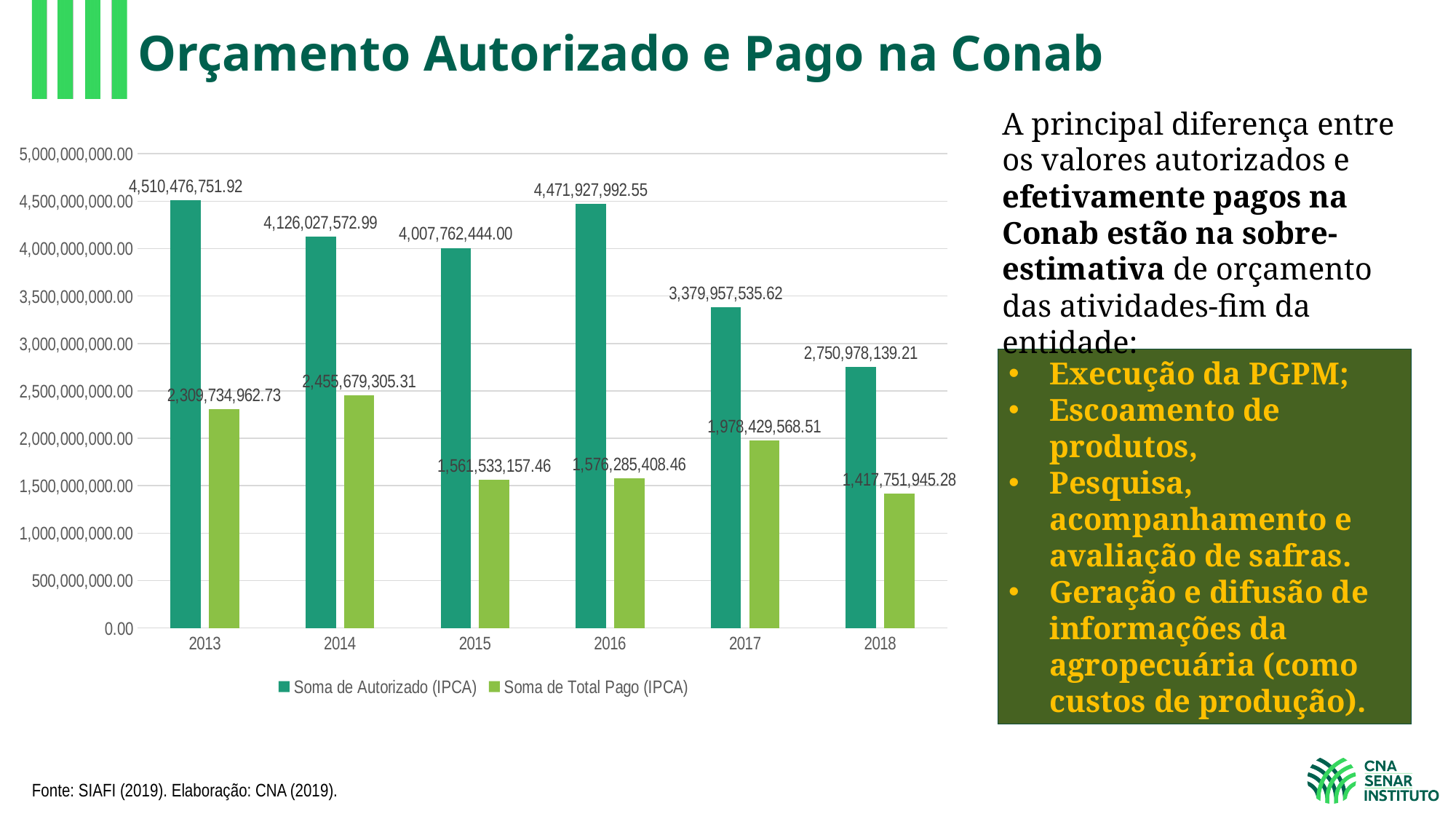
Is the value of Soma de Autorizado (IPCA) for 2017 greater or less than 3,000,000,000.00? greater In which year is Soma de Total Pago (IPCA) lowest? 2018 How many series does the chart legend list? 2 How many years are shown on the x axis of the chart? 6 What is the value of Soma de Total Pago (IPCA) for 2017? 1,978,429,568.51 Does Soma de Autorizado (IPCA) rise or fall from 2016 to 2018? fall What is the value of Soma de Autorizado (IPCA) for 2016? 4,471,927,992.55 In which year is Soma de Autorizado (IPCA) highest? 2013 In which year is Soma de Total Pago (IPCA) highest? 2014 Which is larger, Soma de Total Pago (IPCA) in 2015 or in 2016? 2016 What is the difference between Soma de Autorizado (IPCA) and Soma de Total Pago (IPCA) in 2018? 1,333,226,193.93 What is the value of Soma de Autorizado (IPCA) for 2013? 4,510,476,751.92